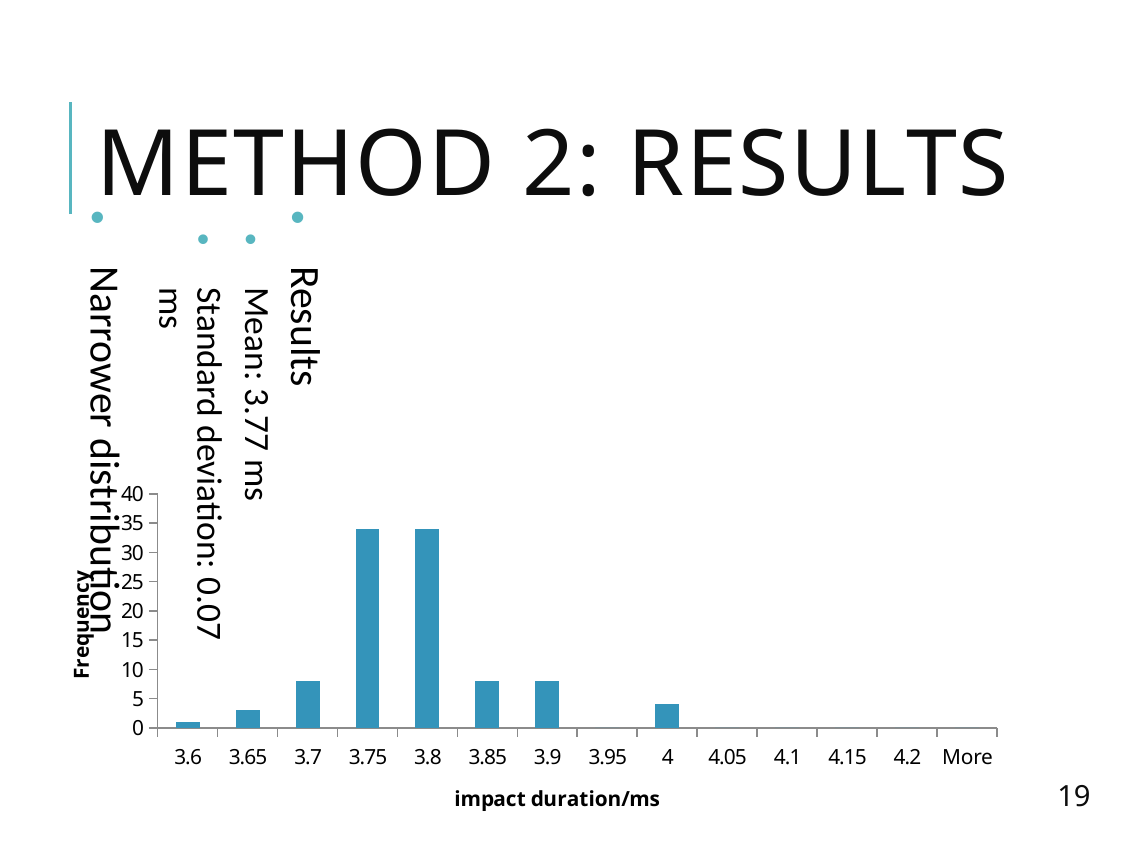
Which has the higher frequency, 3.75 or 3.85? 3.75 Which has the higher frequency, 3.9 or 4? 3.9 Is the frequency for 3.8 greater or less than 25? greater What kind of chart is shown on the slide? bar chart What is the title of the y axis of the chart? Frequency Which has the higher frequency, 3.7 or 3.65? 3.7 How many categories are shown on the x axis of the chart? 14 Is the frequency for 3.7 greater or less than 10? less Is the frequency for 3.75 greater or less than 30? greater What is the title of the x axis of the chart? impact duration/ms